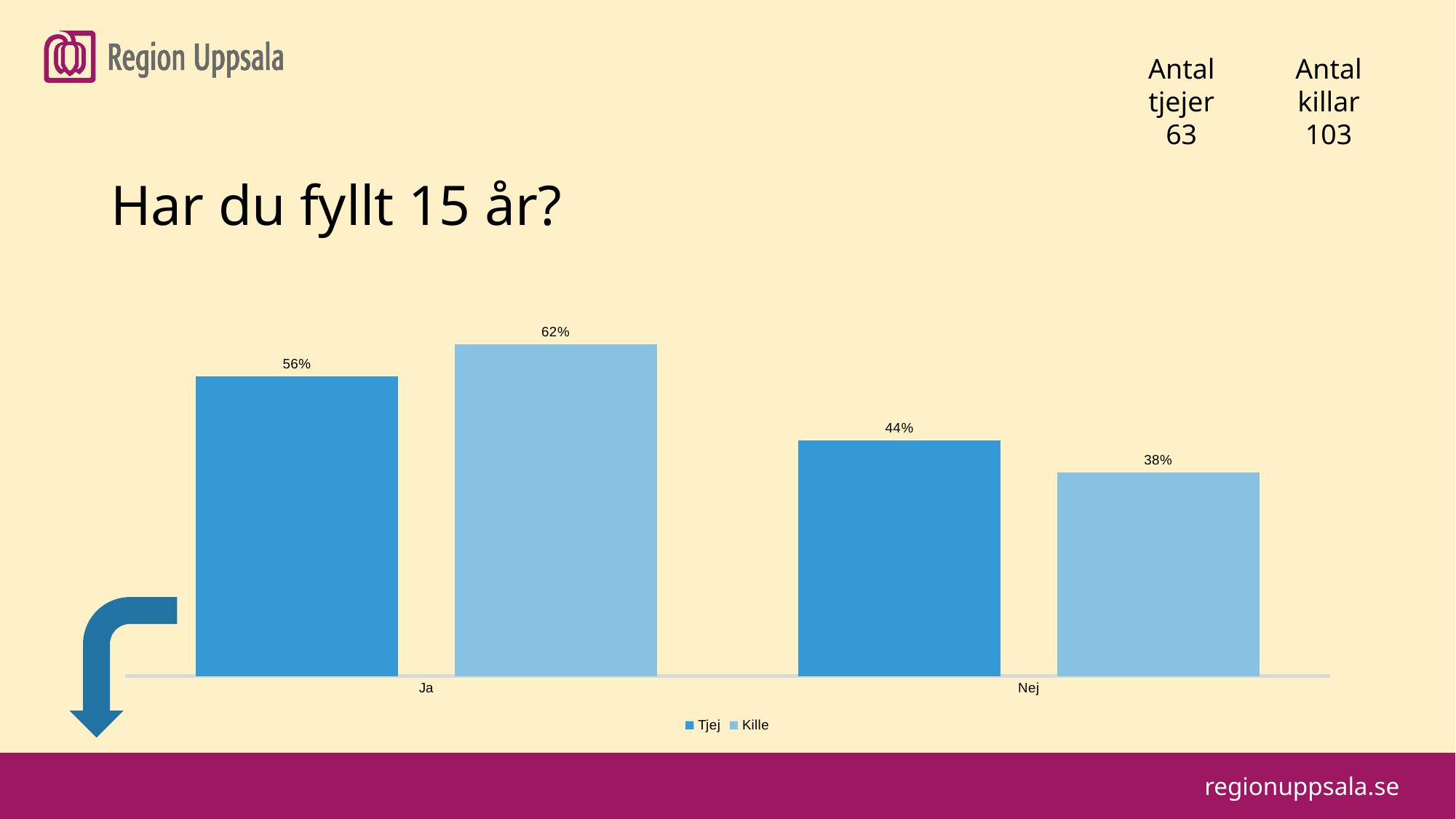
What is the difference between the Kille and Tjej values in the Ja category? 6% Which is larger: the Tjej value for Ja or the Tjej value for Nej? Ja What is the value for Tjej in the Ja category? 56% How many series does the legend list? 2 What is the value for Kille in the Ja category? 62% Which series has the highest value in the Ja category? Kille What is the value for Tjej in the Nej category? 44% What kind of chart is shown on the slide? Bar chart What is the difference between the Tjej and Kille values in the Nej category? 6% Which series has the lowest value in the Nej category? Kille How many categories are shown on the x axis? 2 What is the value for Kille in the Nej category? 38%